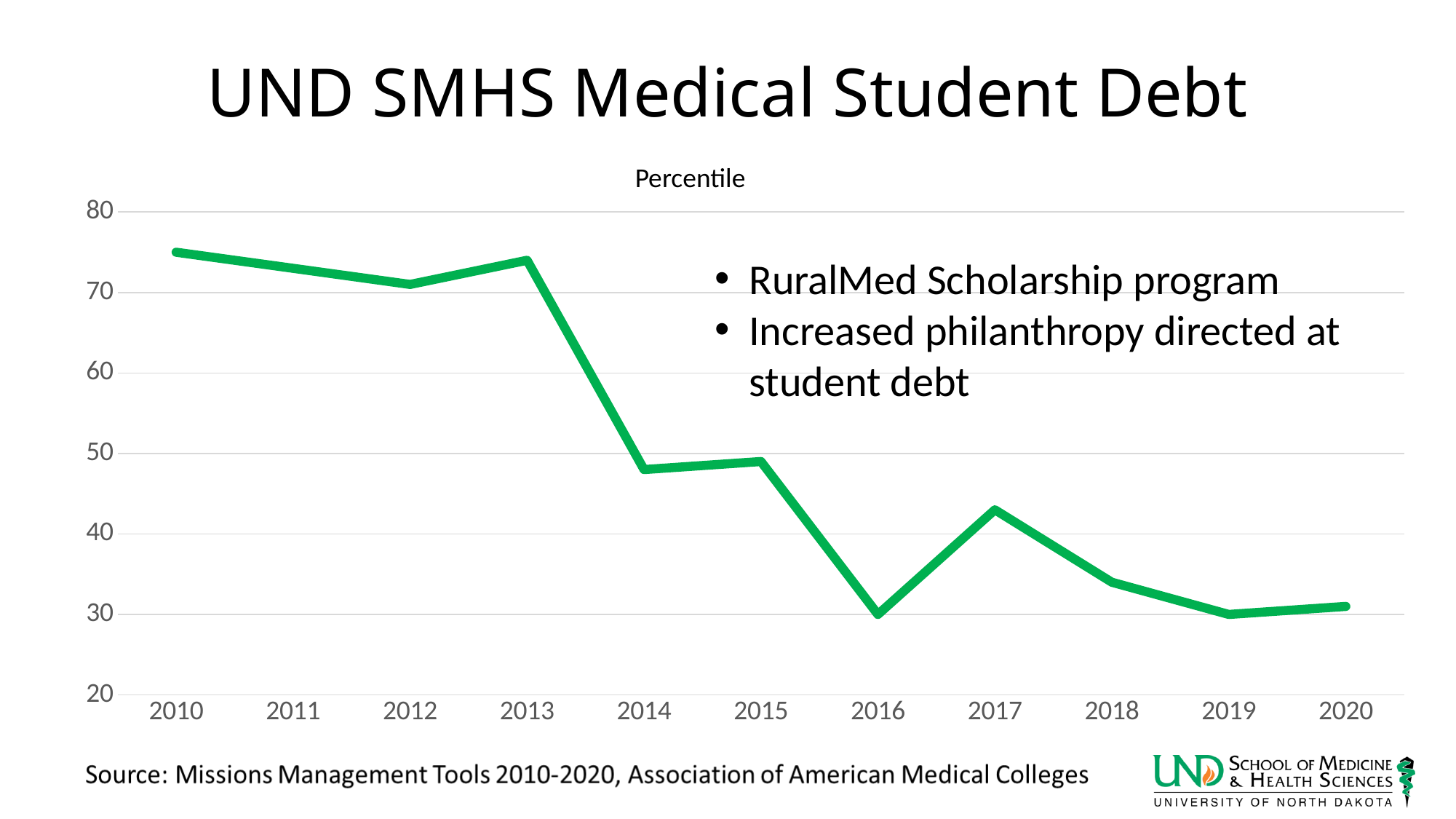
Overall, do the values rise or fall from 2010 to 2020? fall What is the title shown above the chart's plot area? Percentile What kind of chart is shown on the slide? line chart Which year has the larger value, 2017 or 2018? 2017 Is the value for 2016 greater or less than 40? less Is the value for 2017 greater or less than 40? greater What colour is the line in the chart? green Is the value for 2020 greater or less than 40? less Which year has the larger value, 2013 or 2014? 2013 How many years are plotted along the x axis of the chart? 11